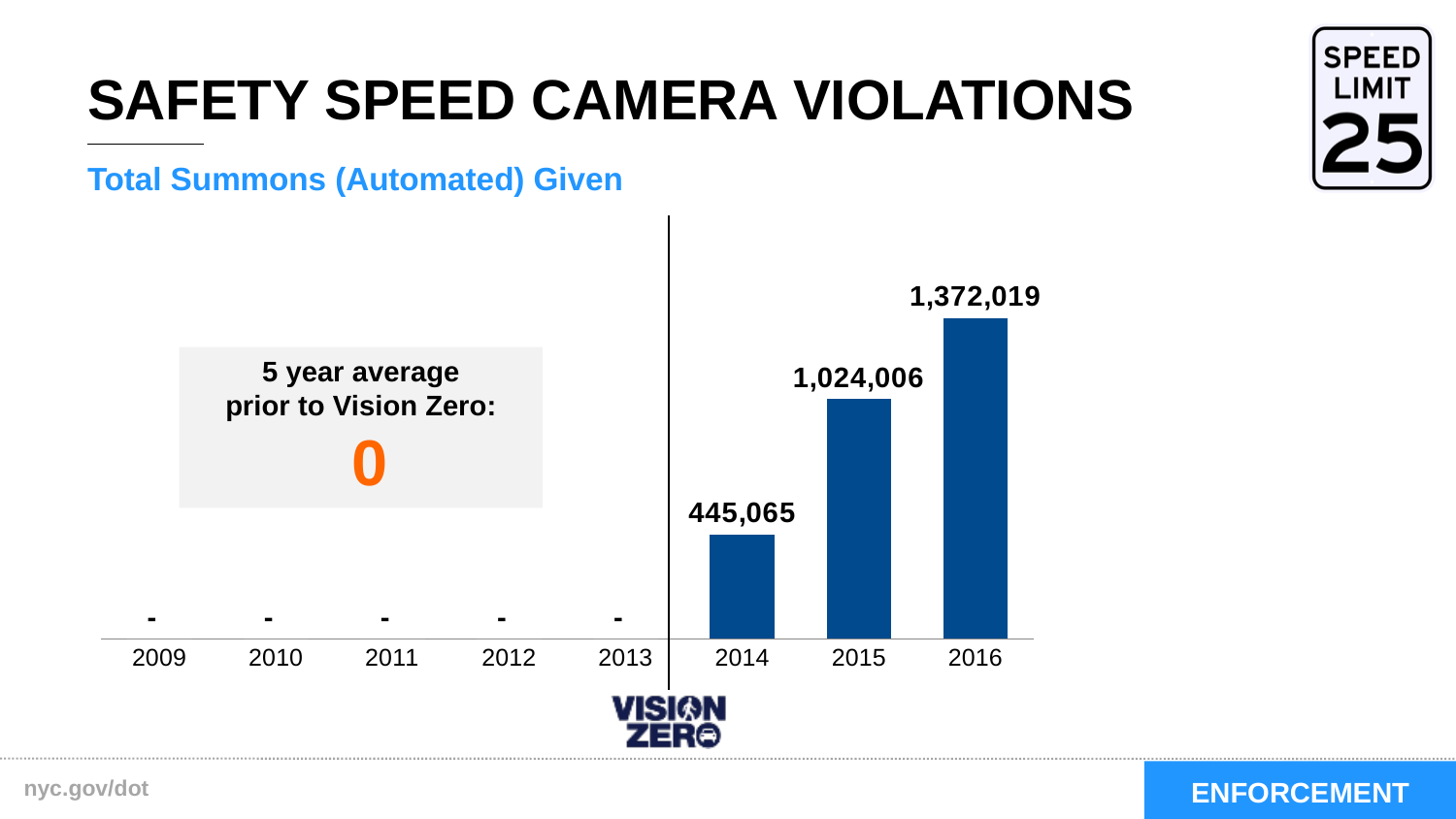
Which year with a plotted bar has the lowest number of summons? 2014 What is the difference between the values for 2016 and 2015? 348,013 How many years are shown on the x axis? 8 Do the values rise or fall from 2014 to 2016? rise What is the difference between the values for 2015 and 2014? 578,941 What is the 5 year average prior to Vision Zero shown in the box? 0 What is the value for 2016? 1,372,019 Which year has the highest number of summons? 2016 Which is larger, the value for 2015 or the value for 2014? 2015 What kind of chart is this? bar chart What is the value for 2014? 445,065 What is the value for 2015? 1,024,006